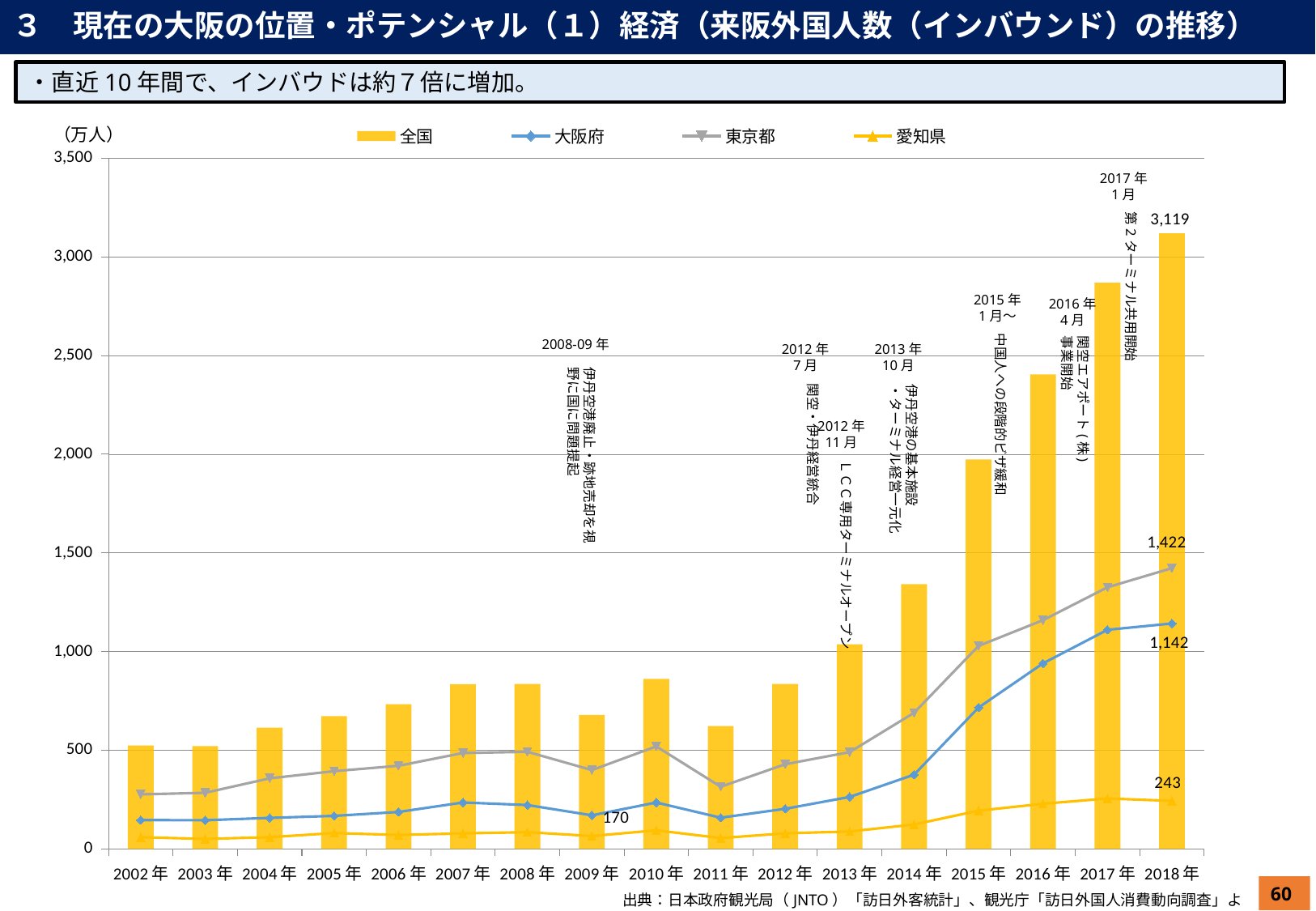
Which is larger in 2018年, the value for 東京都 or the value for 大阪府? 東京都 In which year is the 全国 value highest? 2018年 Is the value for 全国 in 2015年 greater or less than 1,500? greater What is the value for 愛知県 in 2018年? 243 What unit is shown at the top of the y axis? 万人 What is the difference between the 東京都 and 大阪府 values in 2018年? 280 What kind of chart is this? A combination of a bar chart and line charts How many series does the legend list? 4 What is the value for 東京都 in 2018年? 1,422 How many years are shown on the x axis? 17 What is the value for 全国 in 2018年? 3,119 What is the value for 大阪府 in 2018年? 1,142